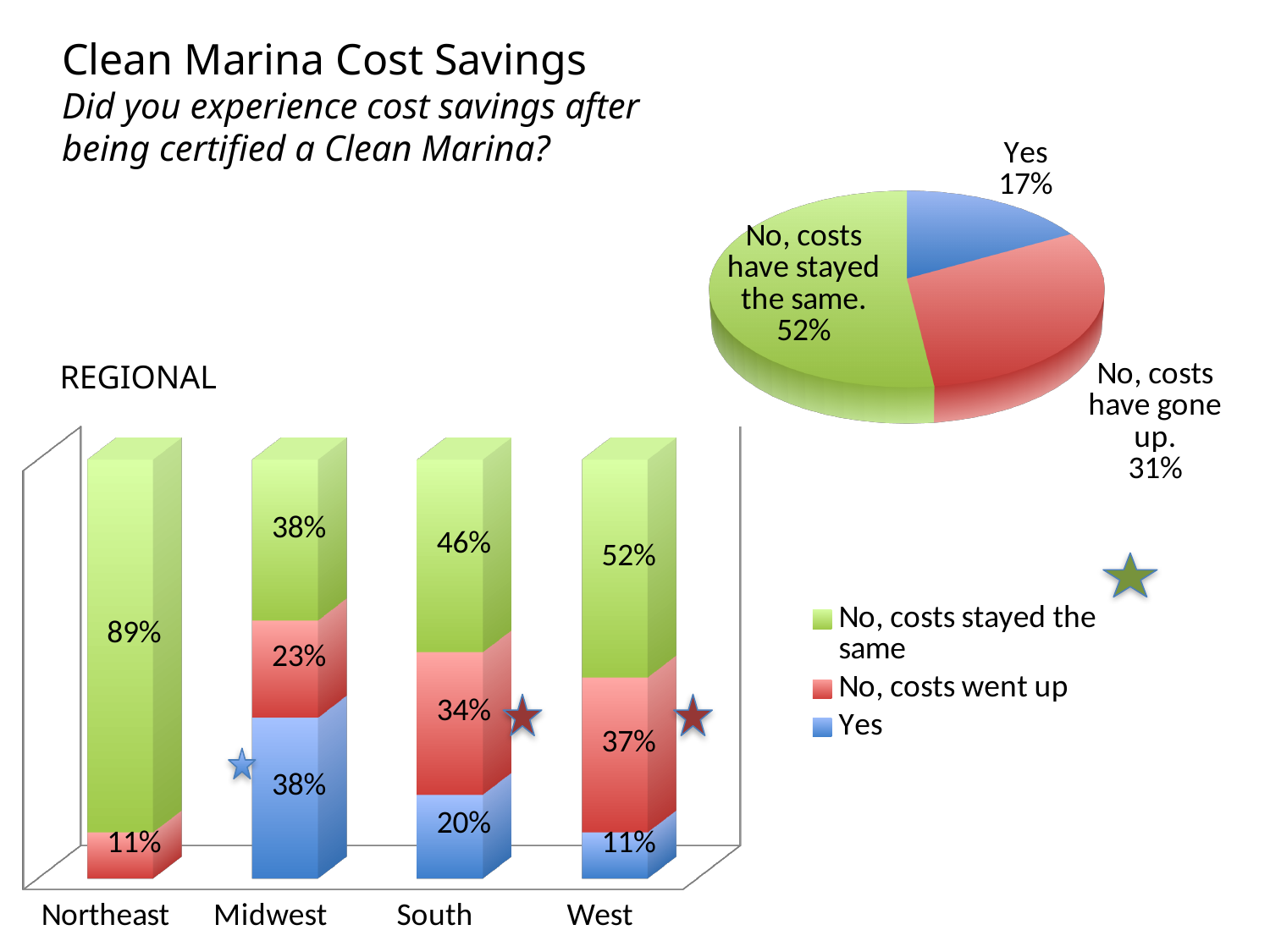
In the REGIONAL bar chart, what is the value for "No, costs stayed the same" in the Northeast? 89% In the REGIONAL bar chart, which region has the lowest "No, costs went up" value? Northeast In the REGIONAL bar chart, which region has the highest "No, costs stayed the same" value? Northeast In the REGIONAL bar chart, what is the difference between the "Yes" values for the South and the West? 9% In the pie chart, what share of respondents answered "Yes"? 17% How many regions are shown in the REGIONAL bar chart? 4 In the pie chart, what is the share for "No, costs have gone up"? 31% In the REGIONAL bar chart, what is the "Yes" value for the Midwest? 38% In the REGIONAL bar chart, what is the "No, costs went up" value for the West? 37% In the pie chart, which response has the largest share? No, costs have stayed the same. How many series does the legend of the REGIONAL bar chart list? 3 In the REGIONAL bar chart, which is larger: the "No, costs went up" value for the South or for the Midwest? South